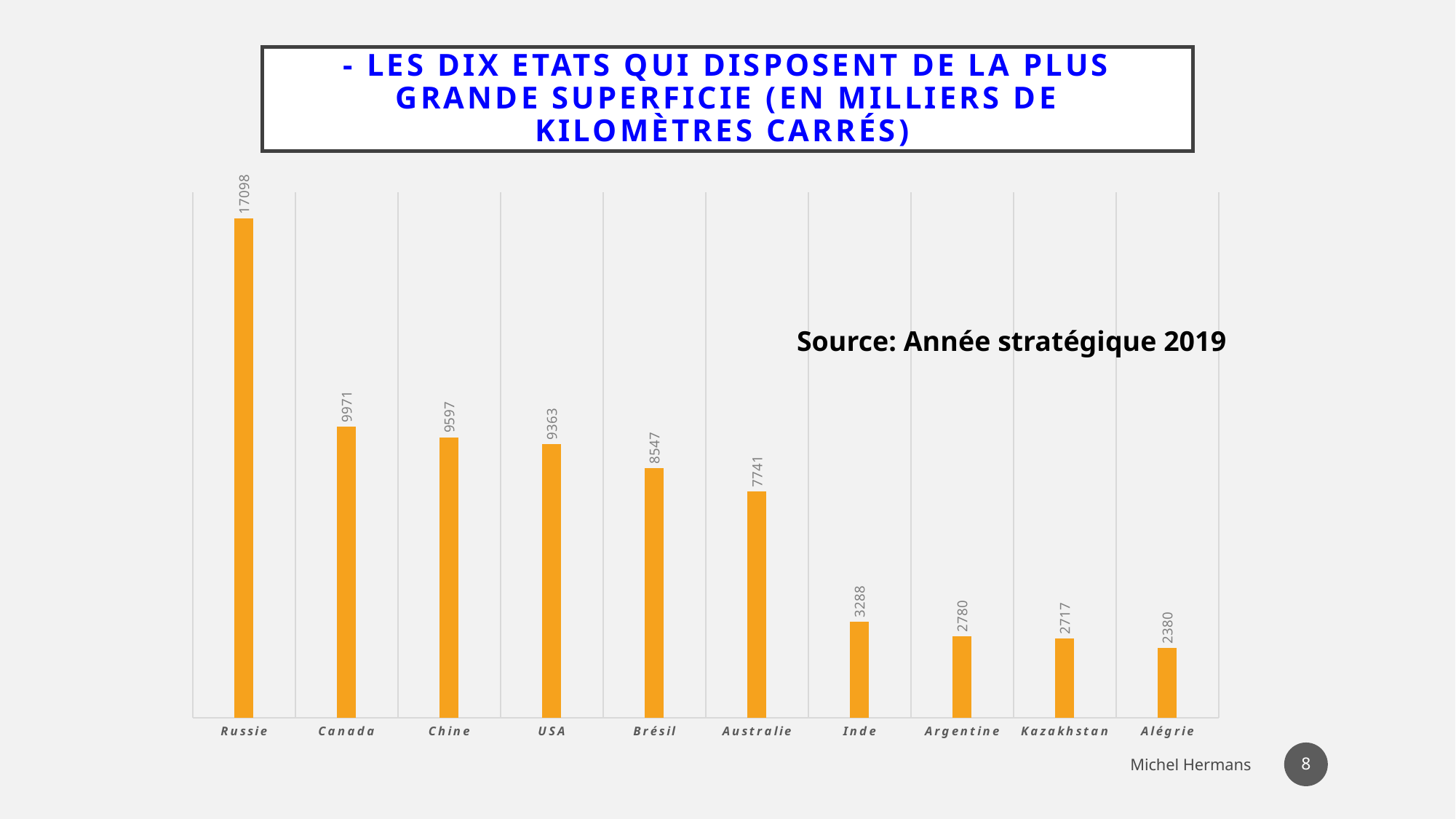
What kind of chart is shown on the slide? Bar chart What is the value shown for Brésil? 8547 Which country has the lowest value on the chart? Alégrie What is the difference between the values for Canada and Chine? 374 How many countries are shown on the chart? 10 What source is cited on the slide for the chart data? Année stratégique 2019 What is the value shown for Russie? 17098 What is the difference between the values for Russie and USA? 7735 Do the values rise or fall from left to right along the x axis? Fall Which has a larger value, Australie or Inde? Australie What is the value shown for Kazakhstan? 2717 Which country has the highest value on the chart? Russie